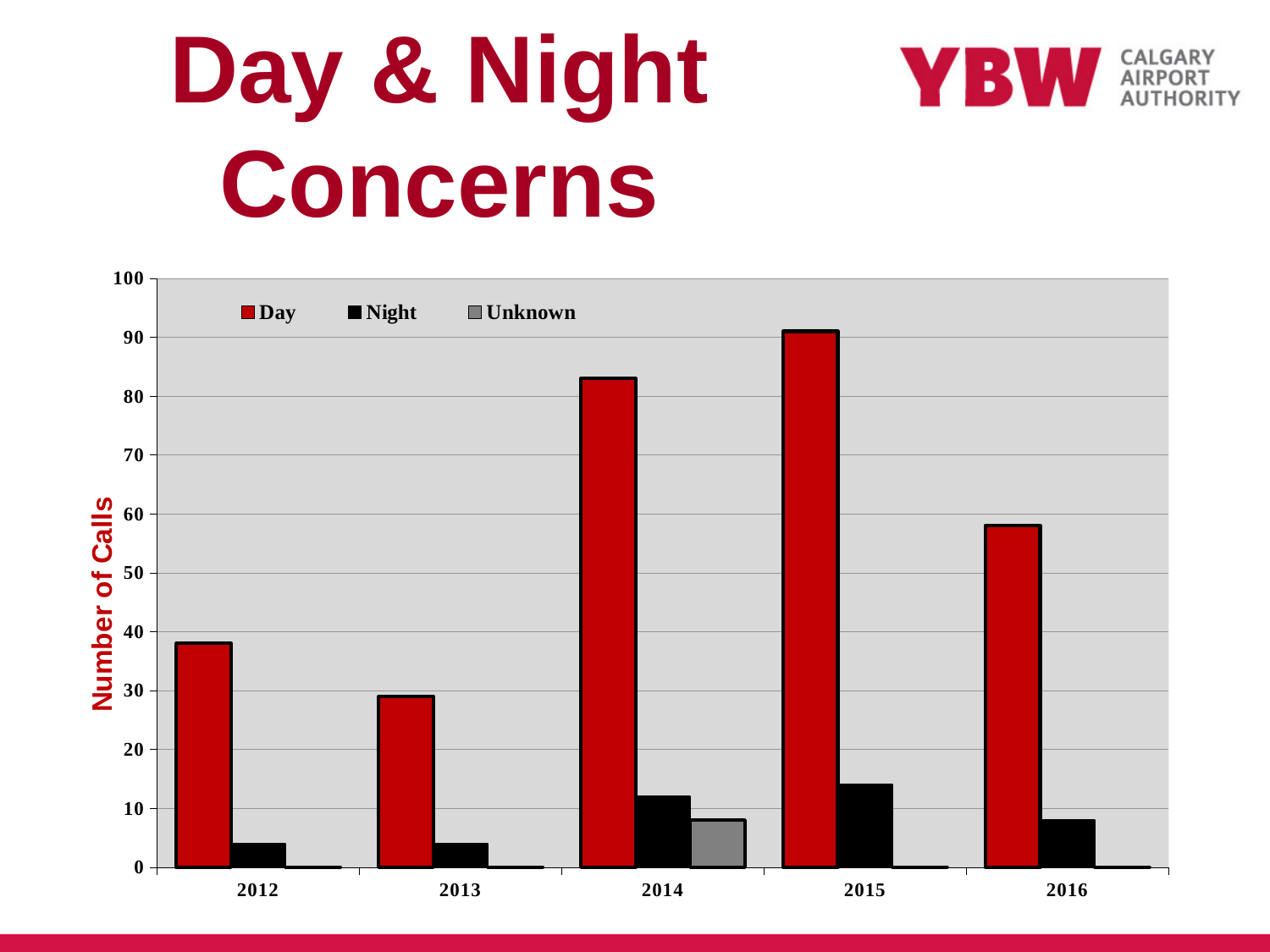
How many years are shown on the x axis? 5 Do the Day values rise or fall from 2013 to 2015? rise Is the Unknown value for 2014 greater or less than 10? less Is the Night value for 2015 greater or less than 10? greater Is the Day value for 2015 greater or less than 80? greater Which year has the larger Day value, 2014 or 2016? 2014 In which year is the Day value highest? 2015 How many series does the legend list? 3 What is the label on the y axis? Number of Calls In which year is the Day value lowest? 2013 What kind of chart is shown on the slide? bar chart